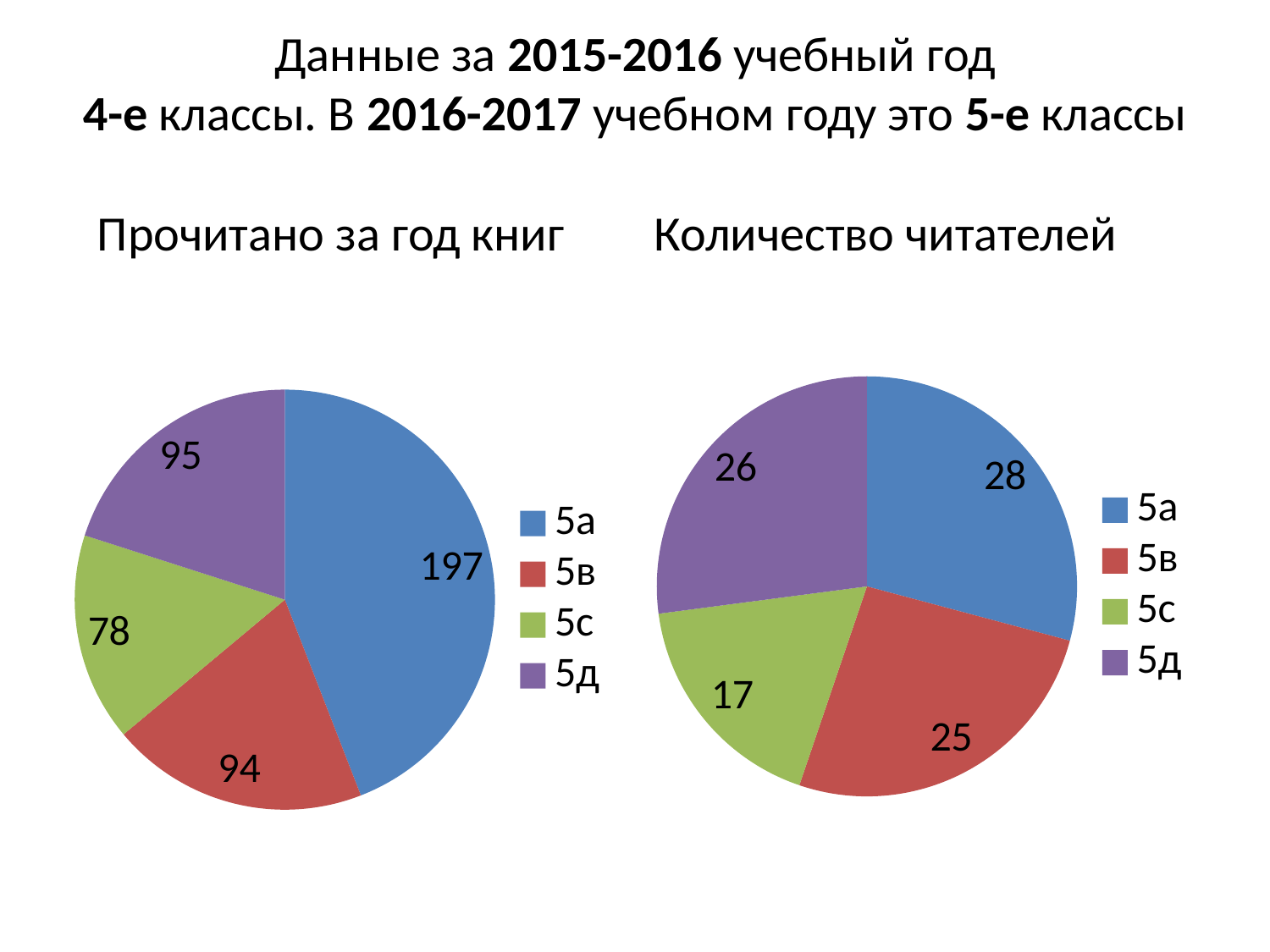
In the chart titled "Количество читателей", what is the value for 5с? 17 In the chart titled "Прочитано за год книг", how many books did class 5а read? 197 In the chart titled "Прочитано за год книг", which class has the smallest slice? 5с In the chart titled "Количество читателей", what colour is the slice for 5в? red In the chart titled "Прочитано за год книг", what is the difference between the values for 5а and 5в? 103 In the chart titled "Количество читателей", which class has the most readers? 5а How many slices does the chart titled "Количество читателей" have? 4 In the chart titled "Количество читателей", what is the difference between the values for 5д and 5с? 9 In the chart titled "Количество читателей", which class has the fewest readers? 5с In the chart titled "Прочитано за год книг", which class has the largest slice? 5а In the chart titled "Прочитано за год книг", which is larger, the value for 5д or the value for 5с? 5д What type of chart is the chart titled "Прочитано за год книг"? pie chart